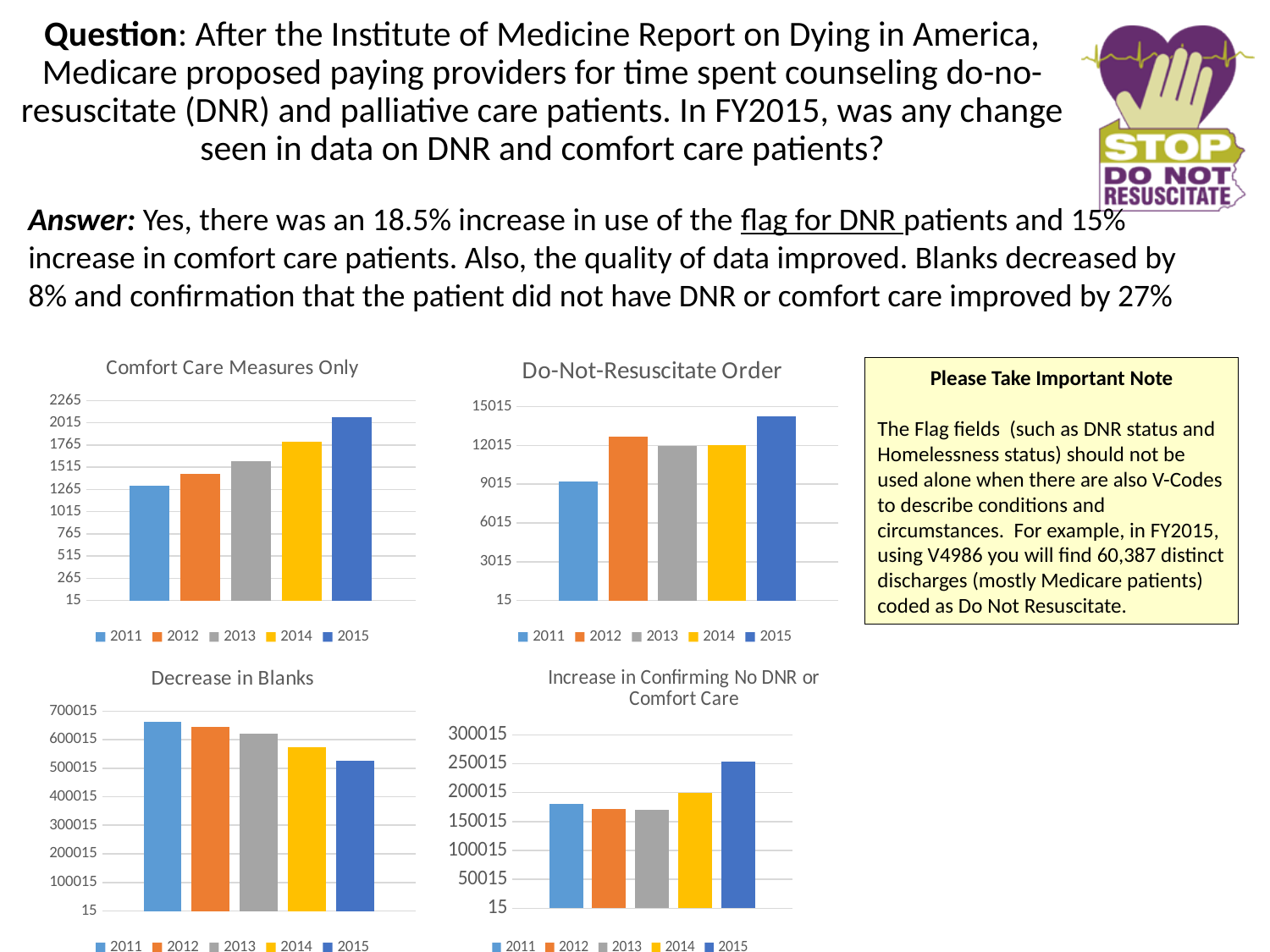
How many bars are plotted in the "Increase in Confirming No DNR or Comfort Care" chart? 5 In the "Increase in Confirming No DNR or Comfort Care" chart, which year has the highest value? 2015 In the "Do-Not-Resuscitate Order" chart, which is larger, the value for 2012 or the value for 2013? 2012 In the "Comfort Care Measures Only" chart, which year has the highest value? 2015 In the "Comfort Care Measures Only" chart, do the values rise or fall from 2011 to 2015? rise In the "Comfort Care Measures Only" chart, is the value for 2015 greater or less than 1765? greater In the "Do-Not-Resuscitate Order" chart, which year has the lowest value? 2011 In the "Do-Not-Resuscitate Order" chart, is the value for 2011 greater or less than 12015? less How many entries does the legend of the "Do-Not-Resuscitate Order" chart list? 5 In the "Decrease in Blanks" chart, is the value for 2015 greater or less than 500015? greater What kind of chart is the "Comfort Care Measures Only" chart? bar chart In the "Decrease in Blanks" chart, do the values rise or fall from 2011 to 2015? fall